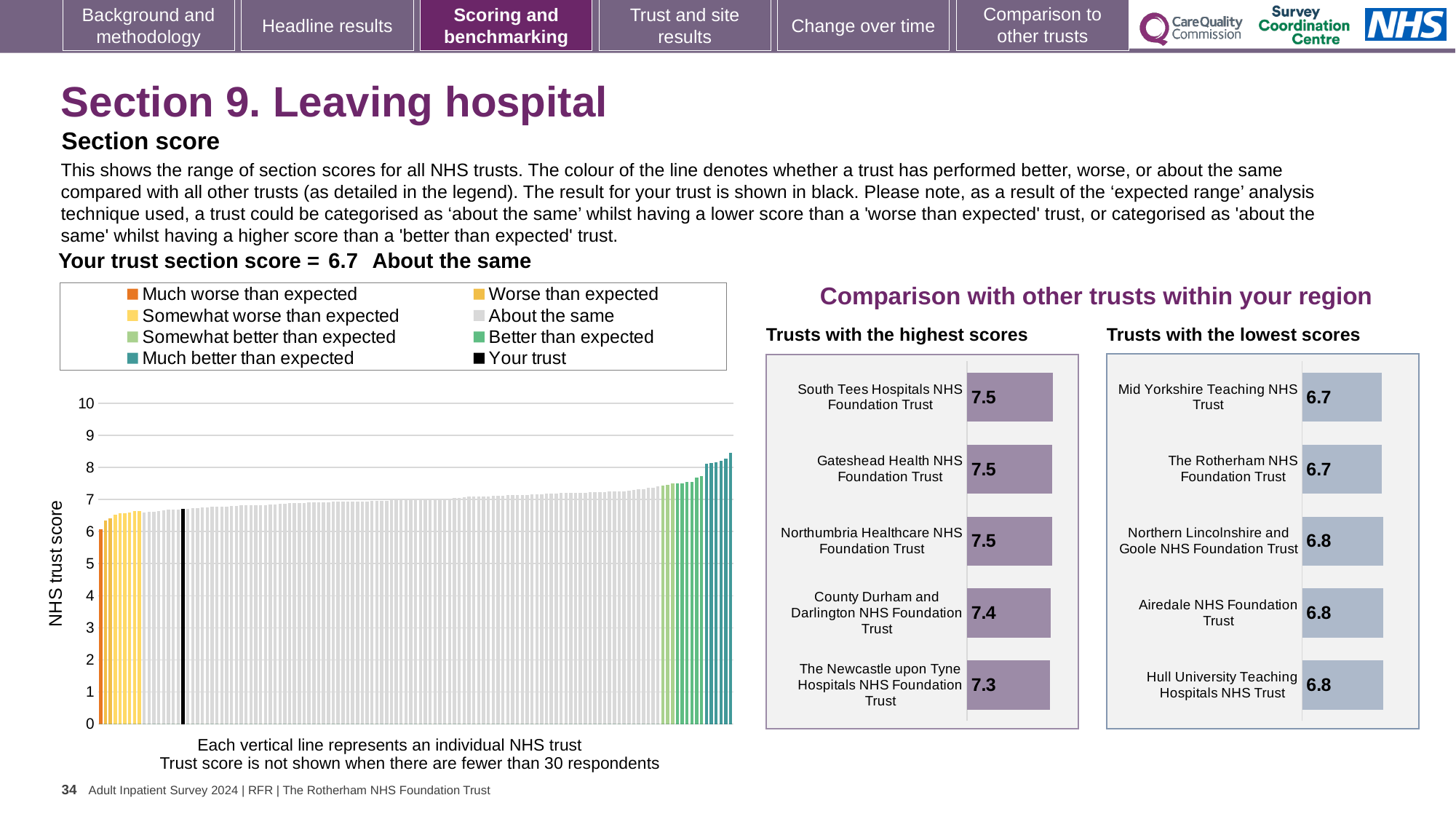
In the 'Trusts with the lowest scores' chart, which is larger: the score for Northern Lincolnshire and Goole NHS Foundation Trust or the score for Mid Yorkshire Teaching NHS Trust? Northern Lincolnshire and Goole NHS Foundation Trust In the NHS trust score chart on the left, do the trust scores rise or fall from left to right? rise In the 'Trusts with the highest scores' chart, how many trusts are listed? 5 In the 'Trusts with the lowest scores' chart, what is the score for Airedale NHS Foundation Trust? 6.8 In the 'Trusts with the highest scores' chart, what is the score for South Tees Hospitals NHS Foundation Trust? 7.5 In the 'Trusts with the lowest scores' chart, what is the difference between the scores of Hull University Teaching Hospitals NHS Trust and The Rotherham NHS Foundation Trust? 0.1 In the 'Trusts with the lowest scores' chart, what is the score for The Rotherham NHS Foundation Trust? 6.7 How many entries does the legend above the NHS trust score chart list? 8 In the 'Trusts with the highest scores' chart, what is the difference between the scores of South Tees Hospitals NHS Foundation Trust and The Newcastle upon Tyne Hospitals NHS Foundation Trust? 0.2 In the 'Trusts with the highest scores' chart, what is the score for The Newcastle upon Tyne Hospitals NHS Foundation Trust? 7.3 In the NHS trust score chart on the left, what is the section score for your trust? 6.7 In the 'Trusts with the highest scores' chart, which trust has the lowest score? The Newcastle upon Tyne Hospitals NHS Foundation Trust